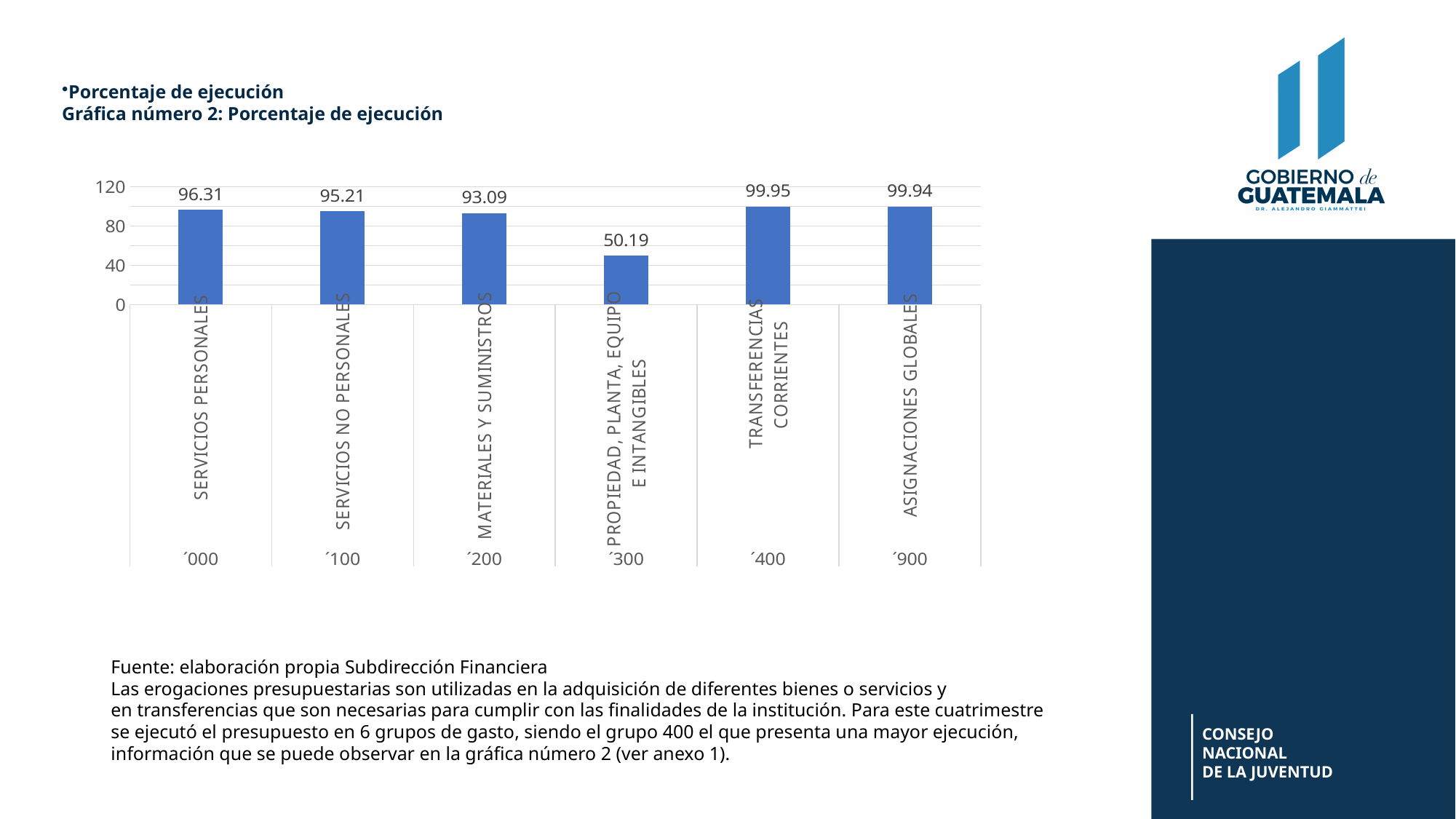
What is the difference between the values for SERVICIOS PERSONALES and SERVICIOS NO PERSONALES? 1.1 Which category has the highest value? TRANSFERENCIAS CORRIENTES What is the value for ASIGNACIONES GLOBALES? 99.94 Is the value for PROPIEDAD, PLANTA, EQUIPO E INTANGIBLES greater or less than 80? less Which is larger, the value for MATERIALES Y SUMINISTROS or the value for SERVICIOS NO PERSONALES? SERVICIOS NO PERSONALES What is the title of the chart? Gráfica número 2: Porcentaje de ejecución How many categories are shown in the chart? 6 What type of chart is shown on the slide? bar chart What is the value for PROPIEDAD, PLANTA, EQUIPO E INTANGIBLES? 50.19 What is the value for SERVICIOS PERSONALES? 96.31 Which category has the lowest value? PROPIEDAD, PLANTA, EQUIPO E INTANGIBLES What is the value for TRANSFERENCIAS CORRIENTES? 99.95